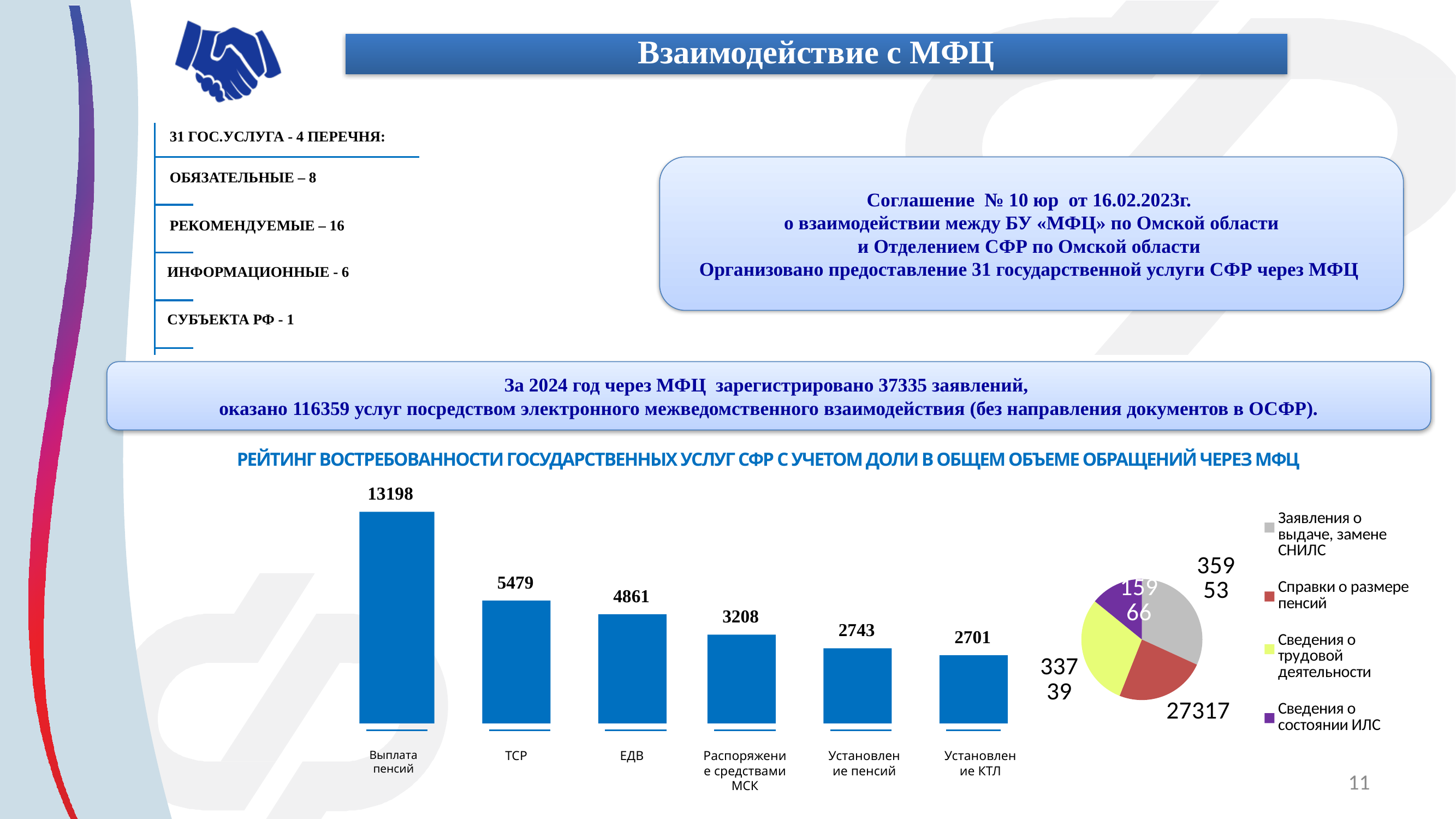
In the bar chart, which is larger: the value for ЕДВ or the value for Распоряжение средствами МСК? ЕДВ In the bar chart, what is the value for Выплата пенсий? 13198 How many entries does the legend of the pie chart list? 4 In the bar chart, what is the difference between the values for ТСР and ЕДВ? 618 What kind of chart is the chart on the left at the bottom of the slide? bar chart In the bar chart, which category has the lowest value? Установление КТЛ In the bar chart, what is the value for ТСР? 5479 In the bar chart, what is the value for Установление КТЛ? 2701 In the bar chart, do the values rise or fall from left to right? fall In the bar chart, which category has the highest value? Выплата пенсий In the pie chart, what is the value for Справки о размере пенсий? 27317 How many categories are shown in the bar chart? 6